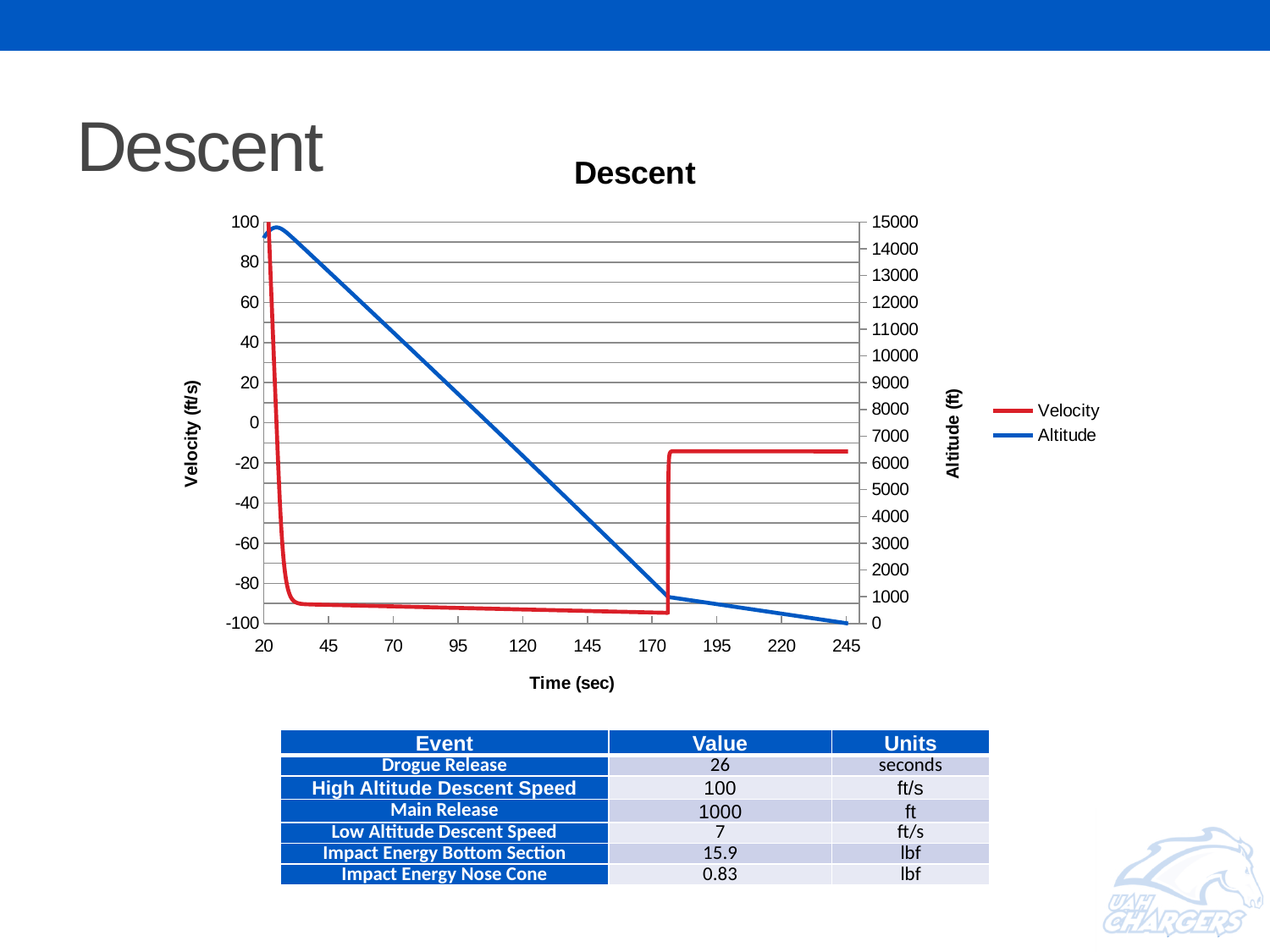
Is the Velocity value at 220 seconds greater or less than 0? less How many series does the chart legend list? 2 What kind of chart is shown on the slide? Line chart Is the Velocity value at 220 seconds greater or less than -40? greater Which series is plotted in red? Velocity What are the two series named in the chart legend? Velocity and Altitude Is the Altitude value at 70 seconds greater or less than 8000? greater Does the Altitude series rise or fall as time increases along the x axis? Fall What is the label of the chart's x axis? Time (sec)